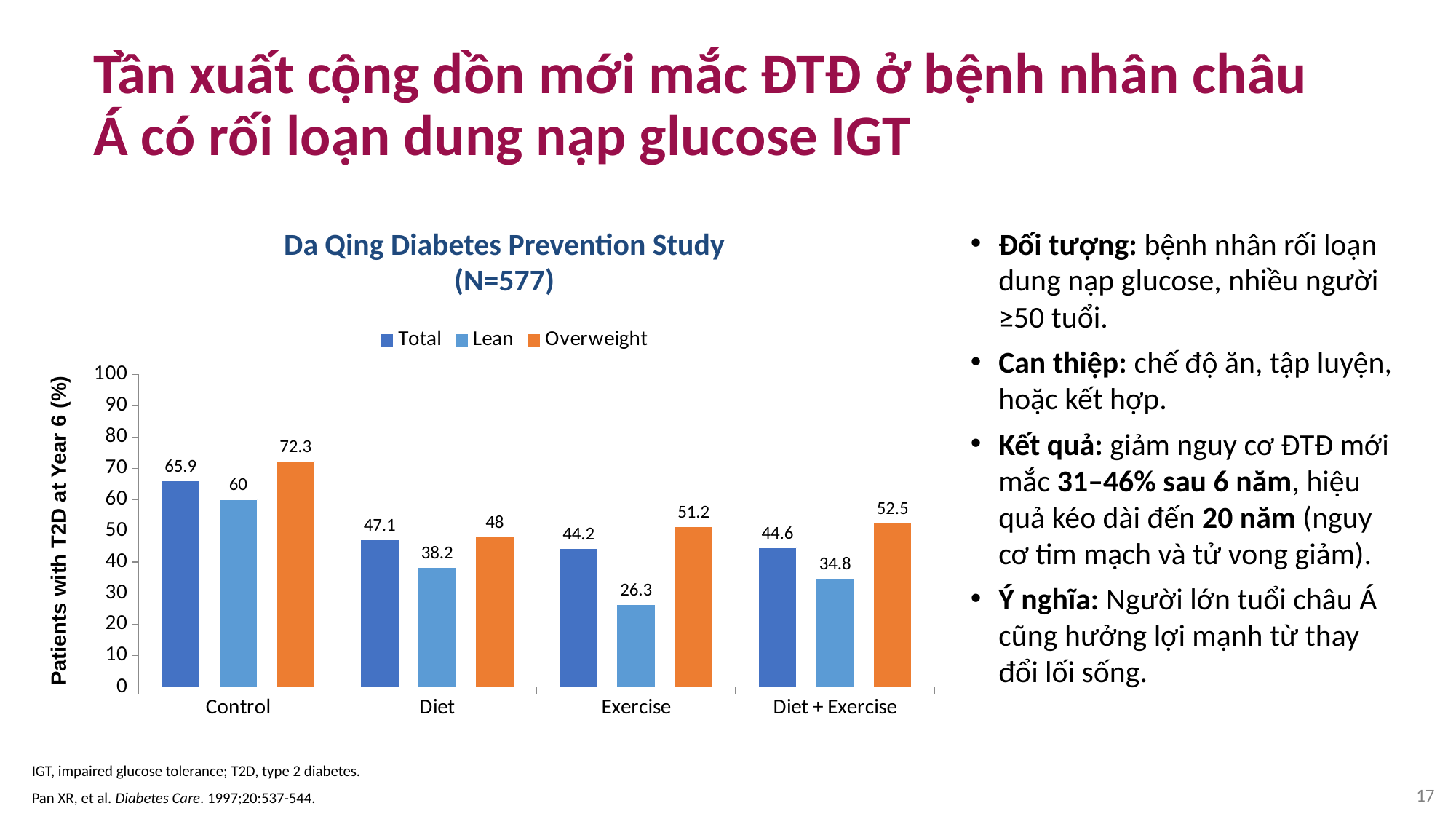
How many series does the legend list? 3 What is the Total value for the Control group? 65.9 What is the difference between the Overweight and Lean values for the Control group? 12.3 Which group has the highest Overweight value? Control How many groups are shown on the x axis? 4 What is the Lean value for the Exercise group? 26.3 Which is larger, the Total value for Diet or the Total value for Exercise? Diet Is the Lean value for Diet + Exercise greater or less than 40? less What kind of chart is shown? bar chart What is the title of the chart? Da Qing Diabetes Prevention Study (N=577) What is the Overweight value for the Diet + Exercise group? 52.5 Which group has the lowest Lean value? Exercise